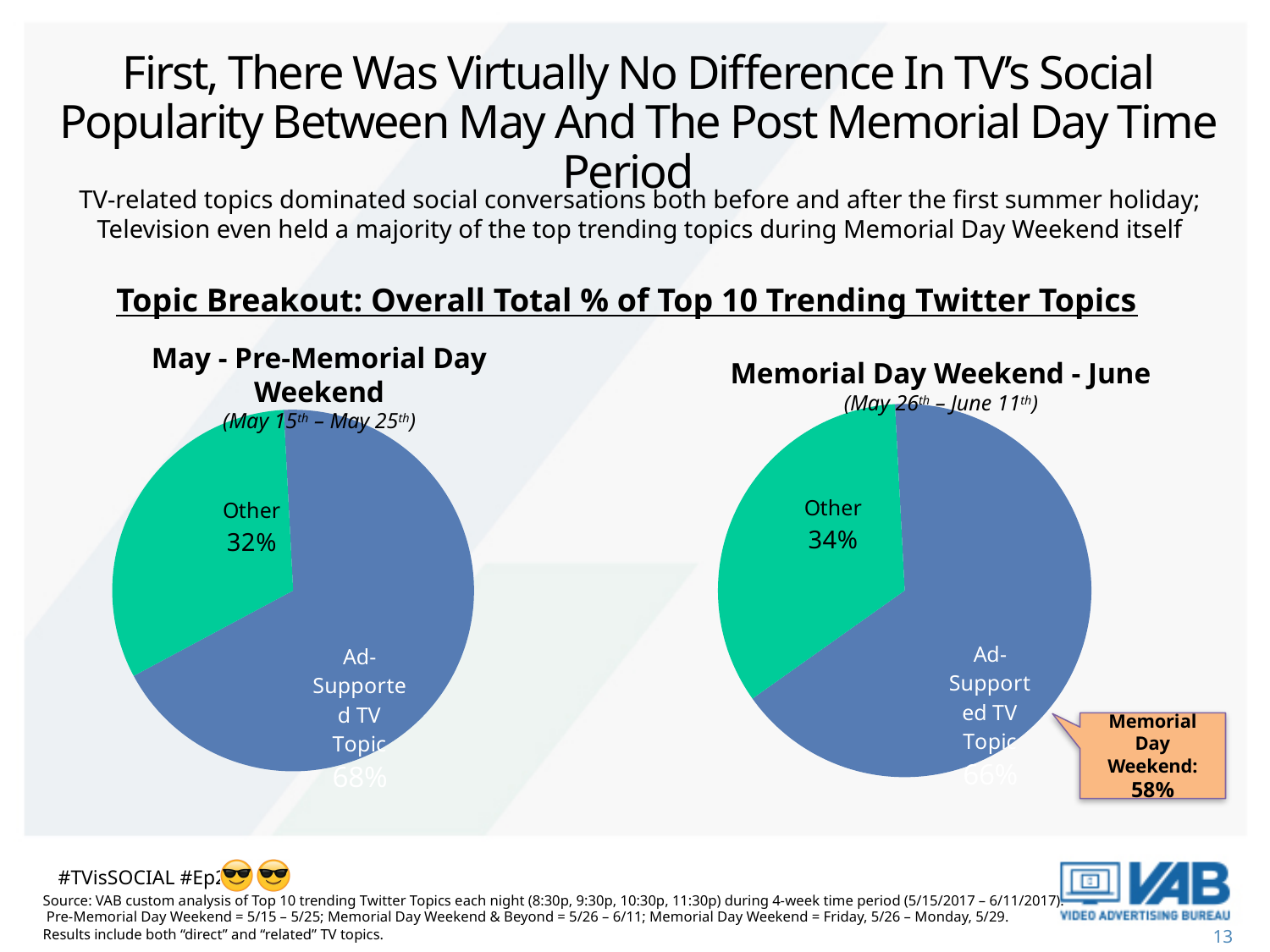
In the Memorial Day Weekend - June pie chart, which slice is the smallest? Other How many slices does the Memorial Day Weekend - June pie chart have? 2 What percentage does the callout box next to the Memorial Day Weekend - June chart give for Memorial Day Weekend? 58% Which chart shows a larger share for Other: May - Pre-Memorial Day Weekend or Memorial Day Weekend - June? Memorial Day Weekend - June In the May - Pre-Memorial Day Weekend pie chart, what share is labelled for Ad-Supported TV Topics? 68% What kind of chart is used for the May - Pre-Memorial Day Weekend data? Pie chart In the May - Pre-Memorial Day Weekend pie chart, which slice is the largest? Ad-Supported TV Topics In the May - Pre-Memorial Day Weekend pie chart, what share is labelled for Other? 32% What is the difference between the Ad-Supported TV Topics share in the May - Pre-Memorial Day Weekend chart and in the Memorial Day Weekend - June chart? 2 percentage points In the Memorial Day Weekend - June pie chart, what share is labelled for Other? 34% In the Memorial Day Weekend - June pie chart, what share is labelled for Ad-Supported TV Topics? 66% What date range is shown under the Memorial Day Weekend - June chart title? May 26th – June 11th